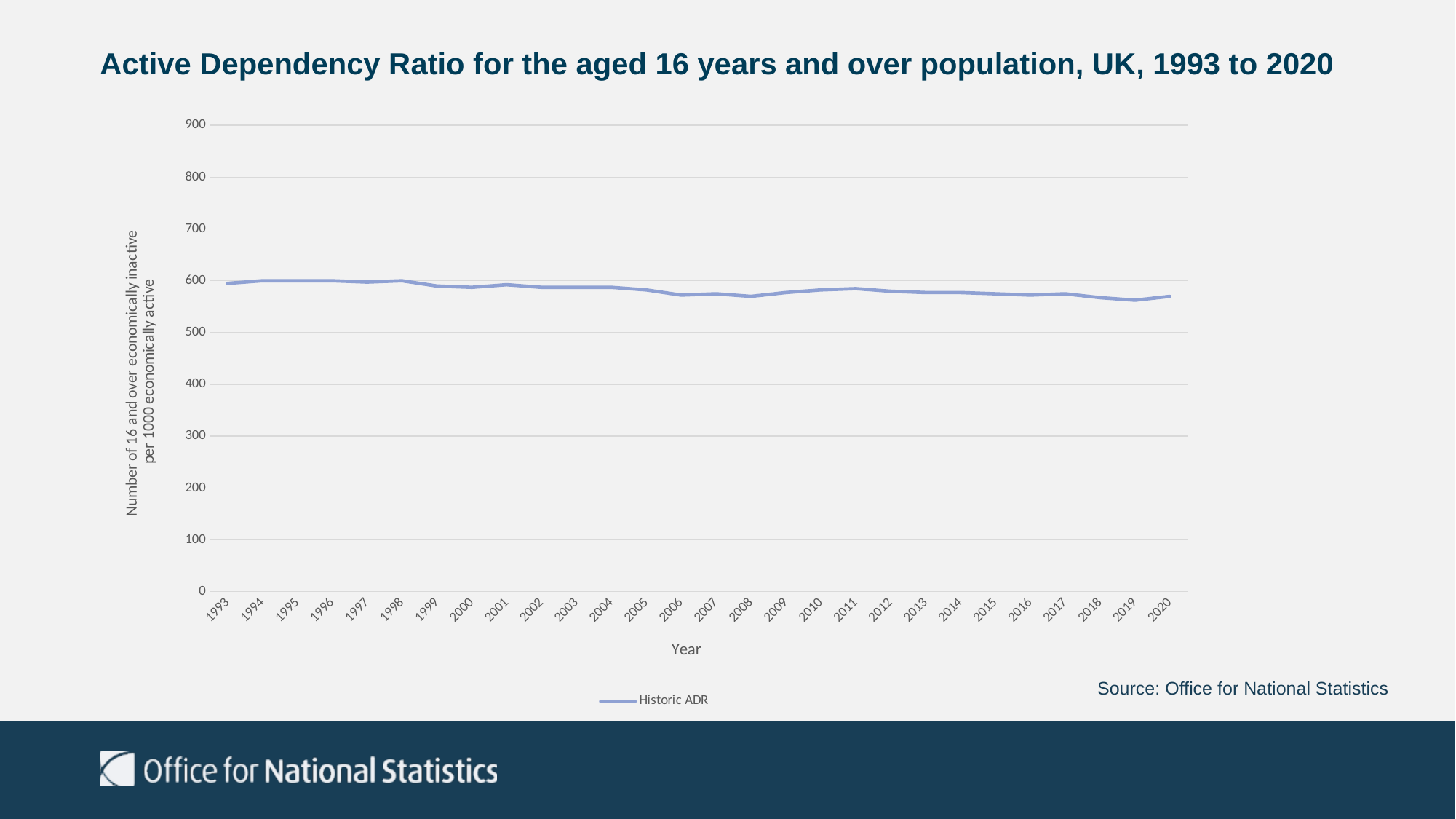
Overall, do the values rise or fall from 1993 to 2020? fall What kind of chart is shown on the slide? line chart Which is larger, the value for 1995 or the value for 2019? 1995 How many years are plotted along the x axis? 28 Is the value for 2019 greater or less than 500? greater Is the value for 2006 greater or less than 600? less Which is larger, the value for 1998 or the value for 2006? 1998 How many series does the legend list? 1 What is the name of the series shown in the legend? Historic ADR Is the value for 1996 greater or less than 700? less What is the title of the x axis? Year